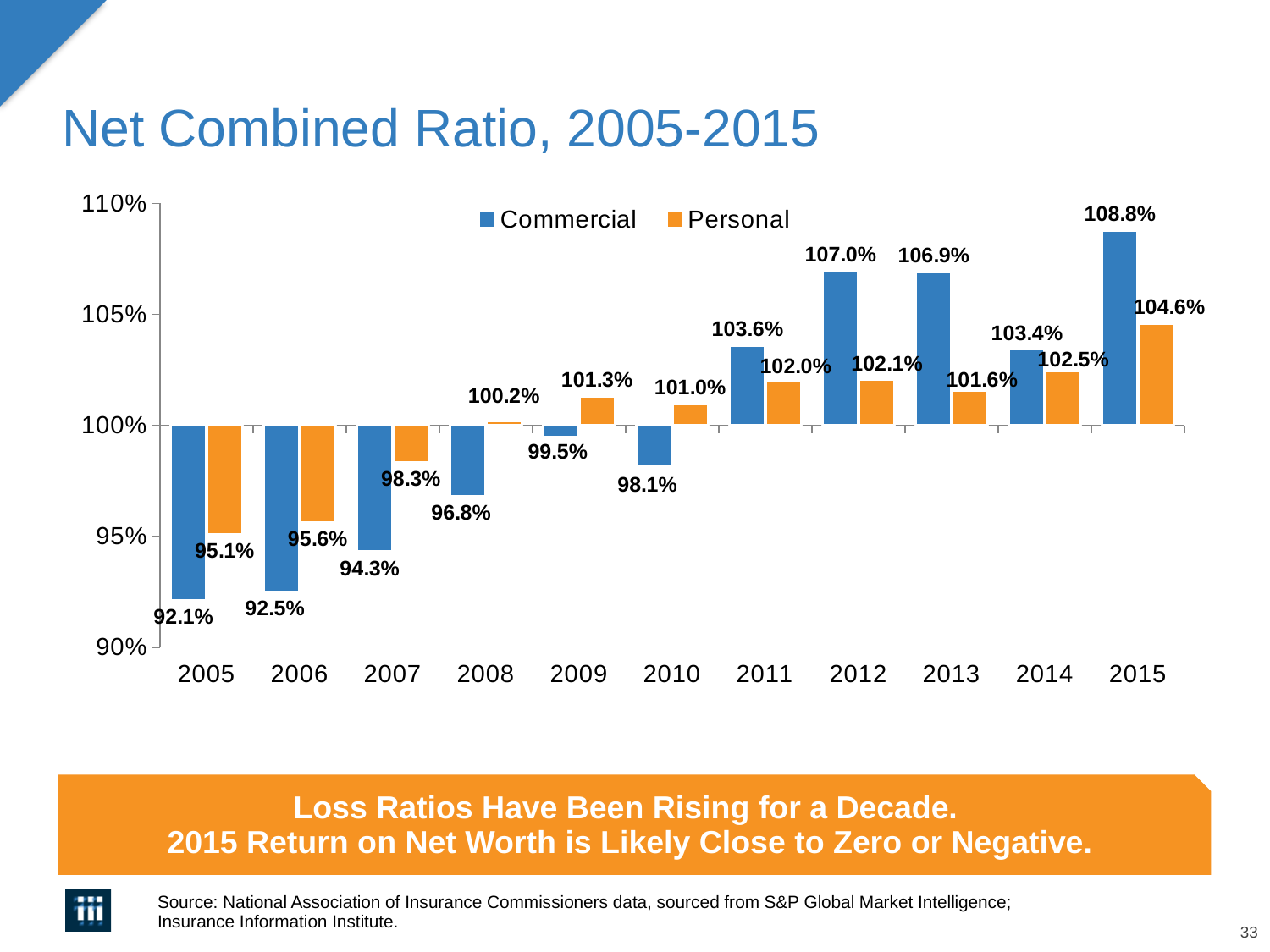
What is the difference between the Commercial and Personal net combined ratios in 2012? 4.9 percentage points What kind of chart is shown on the slide? Bar chart Which is larger in 2007, the Commercial or the Personal net combined ratio? Personal Which year has the lowest Personal net combined ratio? 2005 Which year has the highest Commercial net combined ratio? 2015 What colour represents the Commercial series? Blue What is the Commercial net combined ratio for 2010? 98.1% What is the Personal net combined ratio for 2008? 100.2% Does the Personal net combined ratio generally rise or fall from 2005 to 2015? Rise How many years are shown on the x axis? 11 How many series does the legend list? 2 What is the Commercial net combined ratio for 2015? 108.8%